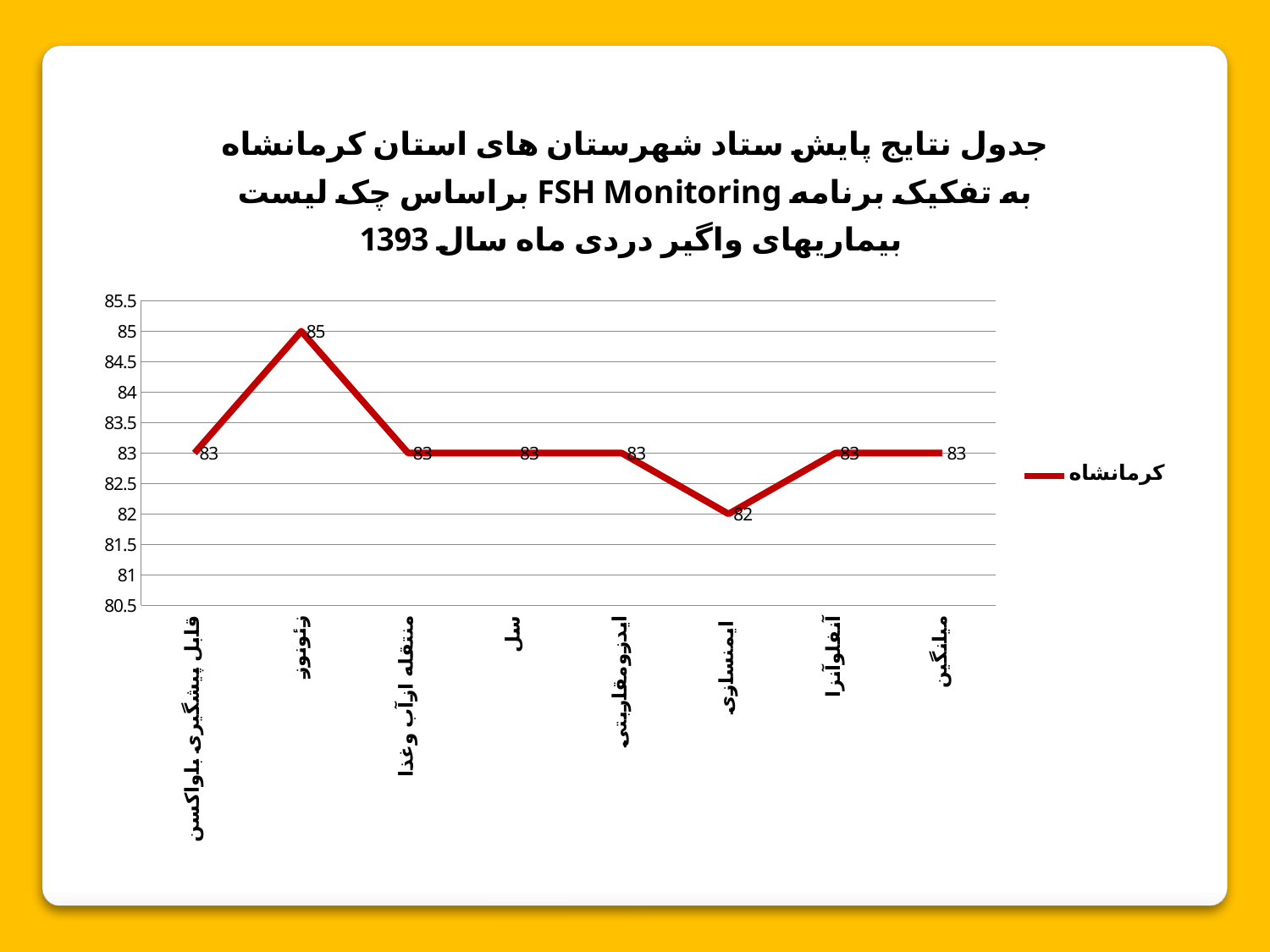
Which category has the highest value? زئونوز What is the value for میانگین? 83 Which category has the lowest value? ایمنسازی What is the value for زئونوز? 85 Is the value for ایمنسازی greater or less than 83? less What is the difference between the values for زئونوز and ایمنسازی? 3 What is the value for ایمنسازی? 82 What is the value for سل? 83 How many series does the legend list? 1 Which is larger, the value for زئونوز or the value for آنفلوآنزا? زئونوز How many categories are shown on the x axis? 8 What kind of chart is shown on the slide? line chart